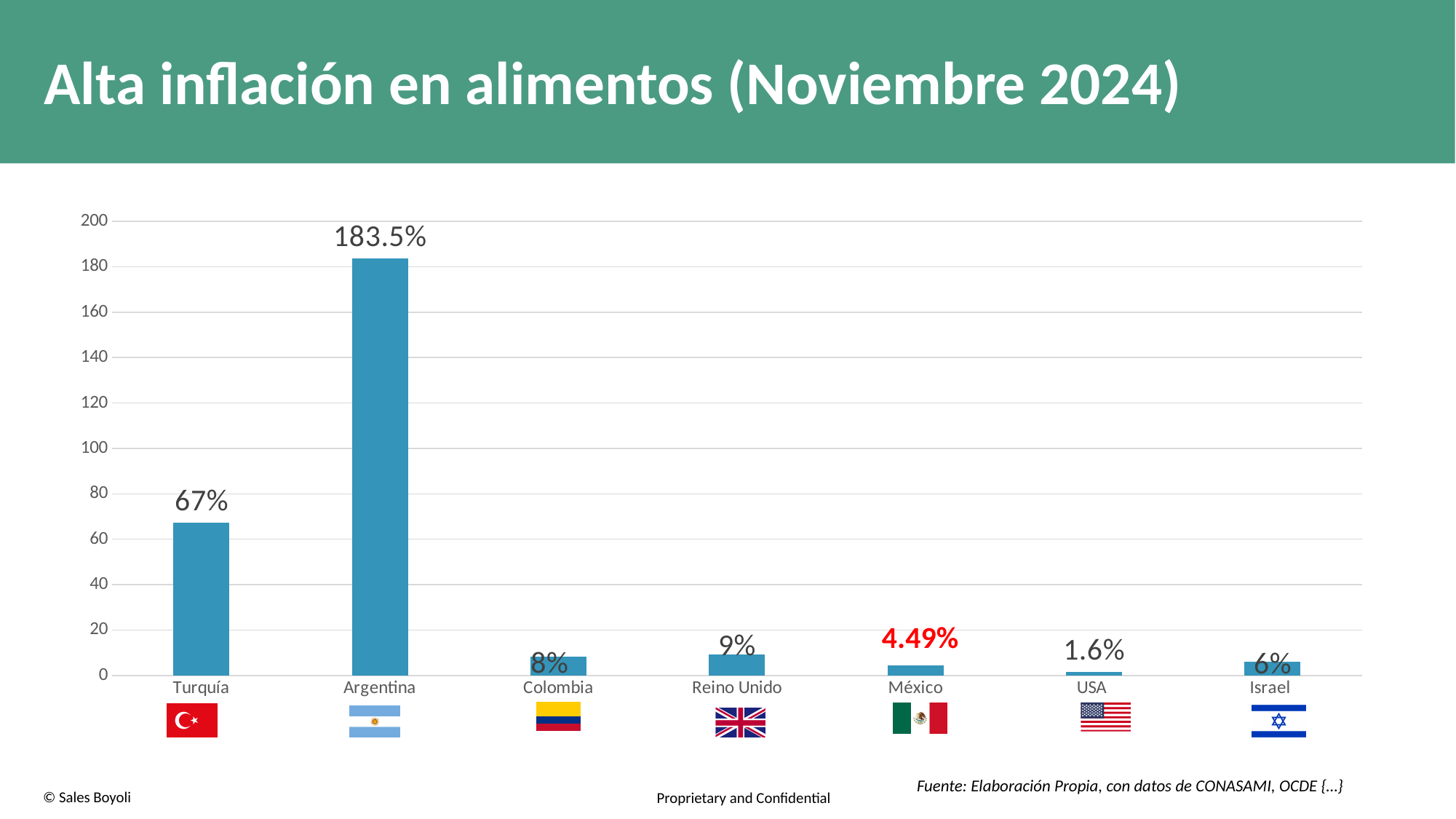
What is the difference between the values for Argentina and Turquía? 116.5% Which country has the lowest value on the chart? USA What is the value shown for México? 4.49% What kind of chart is shown on the slide? Bar chart What is the value shown for USA? 1.6% Which country's data label is shown in red? México Is the value for Turquía greater or less than 80? less What is the value shown for Turquía? 67% Which has a larger value, Reino Unido or Colombia? Reino Unido How many countries are shown on the chart? 7 Which country has the highest value on the chart? Argentina What is the value shown for Argentina? 183.5%